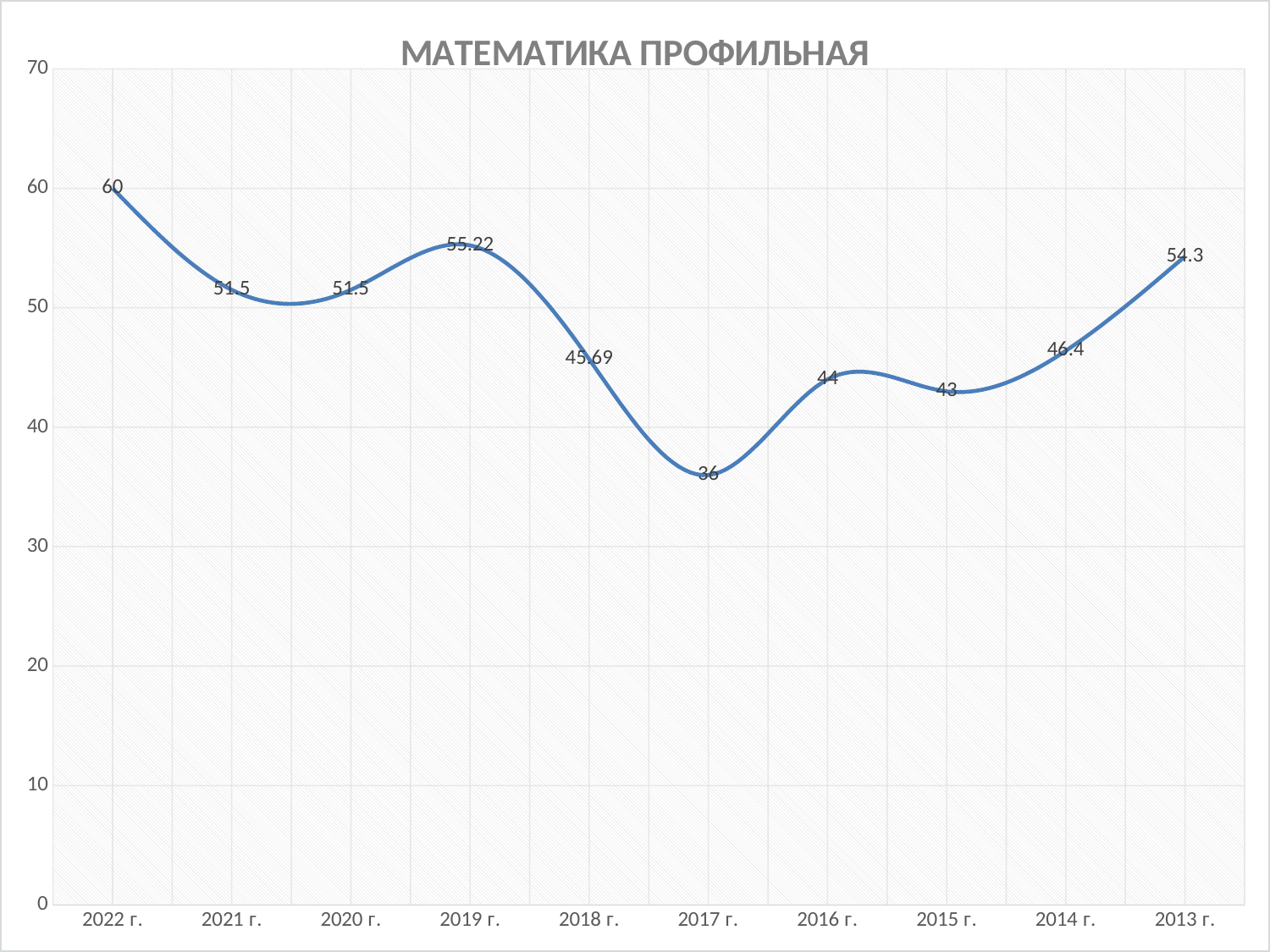
What is the difference between the values for 2022 г. and 2017 г.? 24 How many years are plotted on the chart? 10 Which year has the highest value? 2022 г. What is the value for 2022 г.? 60 Which year has the lowest value? 2017 г. What is the difference between the values for 2014 г. and 2015 г.? 3.4 What is the value for 2019 г.? 55.22 What is the value for 2018 г.? 45.69 Which is larger, the value for 2016 г. or the value for 2014 г.? 2014 г. What is the title of the chart? МАТЕМАТИКА ПРОФИЛЬНАЯ What kind of chart is this? line chart What is the value for 2013 г.? 54.3